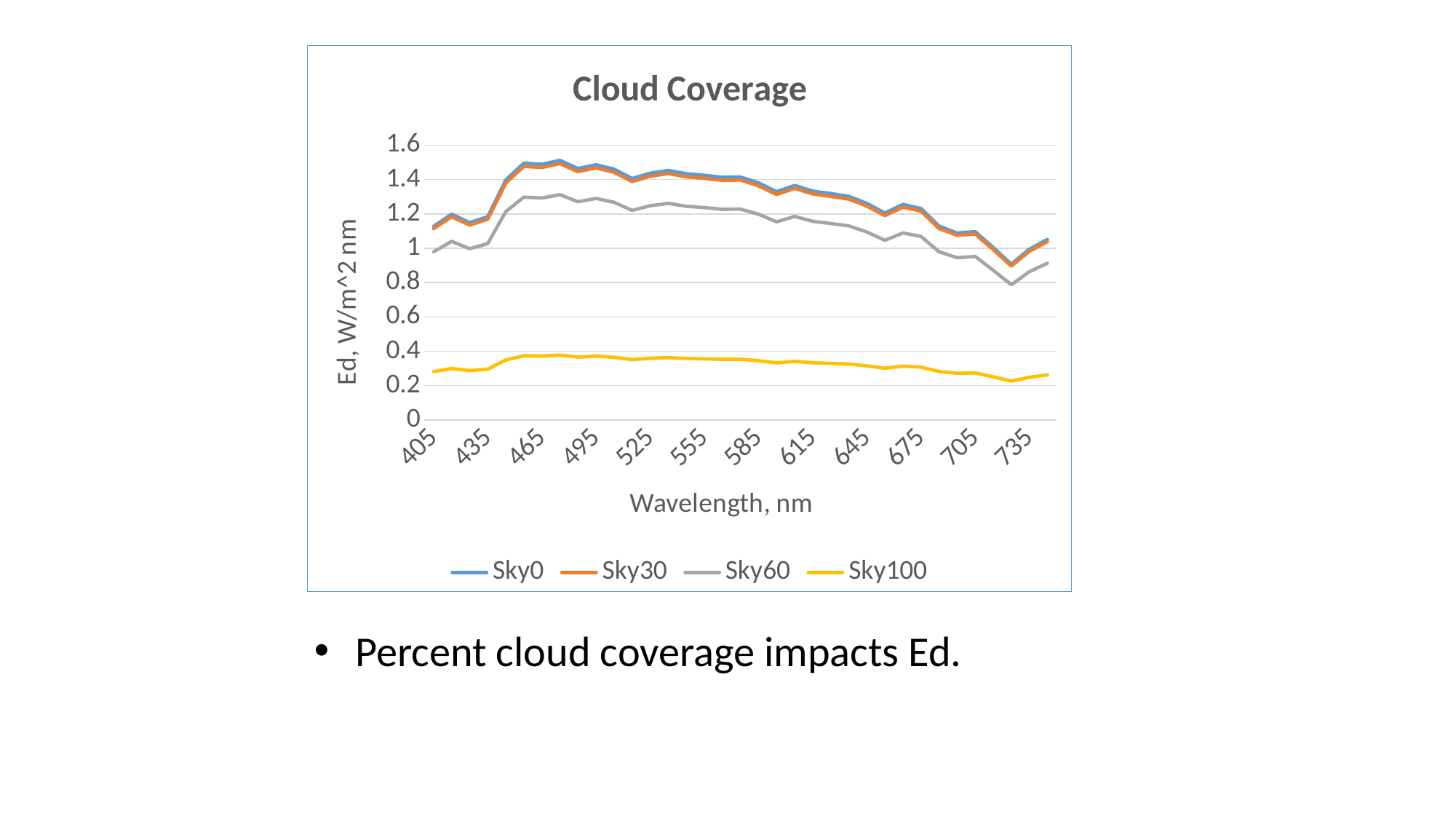
Is the value for Sky60 at 735 nm greater or less than 1? less Is the value for Sky100 at 405 nm greater or less than 0.4? less Is the value for Sky100 at 645 nm greater or less than 0.2? greater What kind of chart is shown on the slide? line chart At 525 nm, which is larger, the value for Sky0 or the value for Sky100? Sky0 Does the Sky100 series rise or fall from 495 nm to 735 nm? fall What is the title of the chart? Cloud Coverage What is the label of the y axis? Ed, W/m^2 nm Which series has the highest values across the whole wavelength range? Sky0 How many series does the legend list? 4 Which series has the lowest values across the whole wavelength range? Sky100